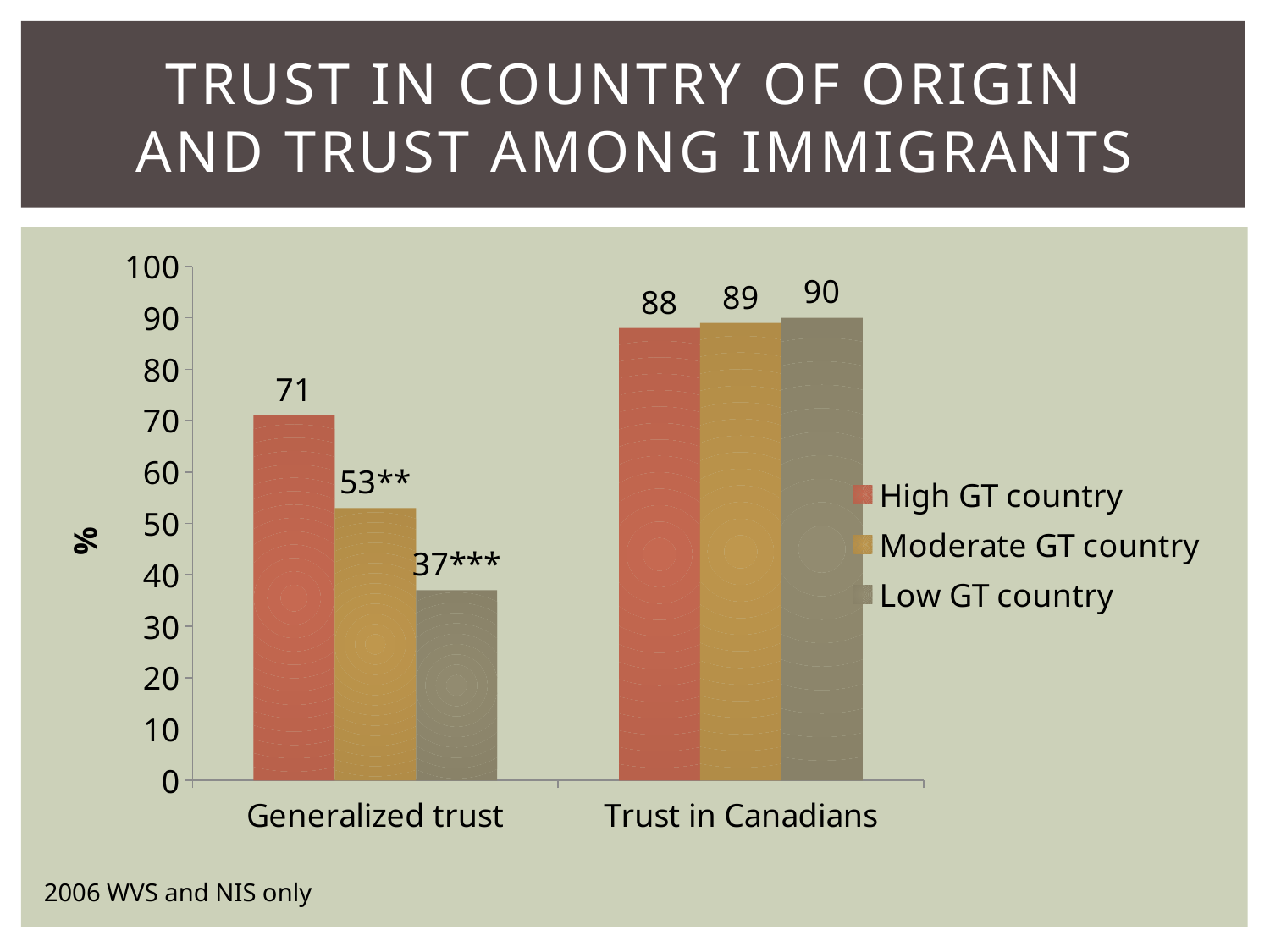
Which is larger for High GT country: Generalized trust or Trust in Canadians? Trust in Canadians What is the difference between the High GT country and Low GT country values under Generalized trust? 34 How many categories are shown on the x axis? 2 How many series does the legend list? 3 Which series has the highest value under Generalized trust? High GT country What is the difference between the Low GT country values for Trust in Canadians and Generalized trust? 53 What is the value for Moderate GT country under Generalized trust? 53** Which series has the lowest value under Generalized trust? Low GT country What is the value for High GT country under Generalized trust? 71 What kind of chart is shown on the slide? Bar chart What is the value for Low GT country under Trust in Canadians? 90 Is the value for Moderate GT country under Trust in Canadians greater or less than 80? greater